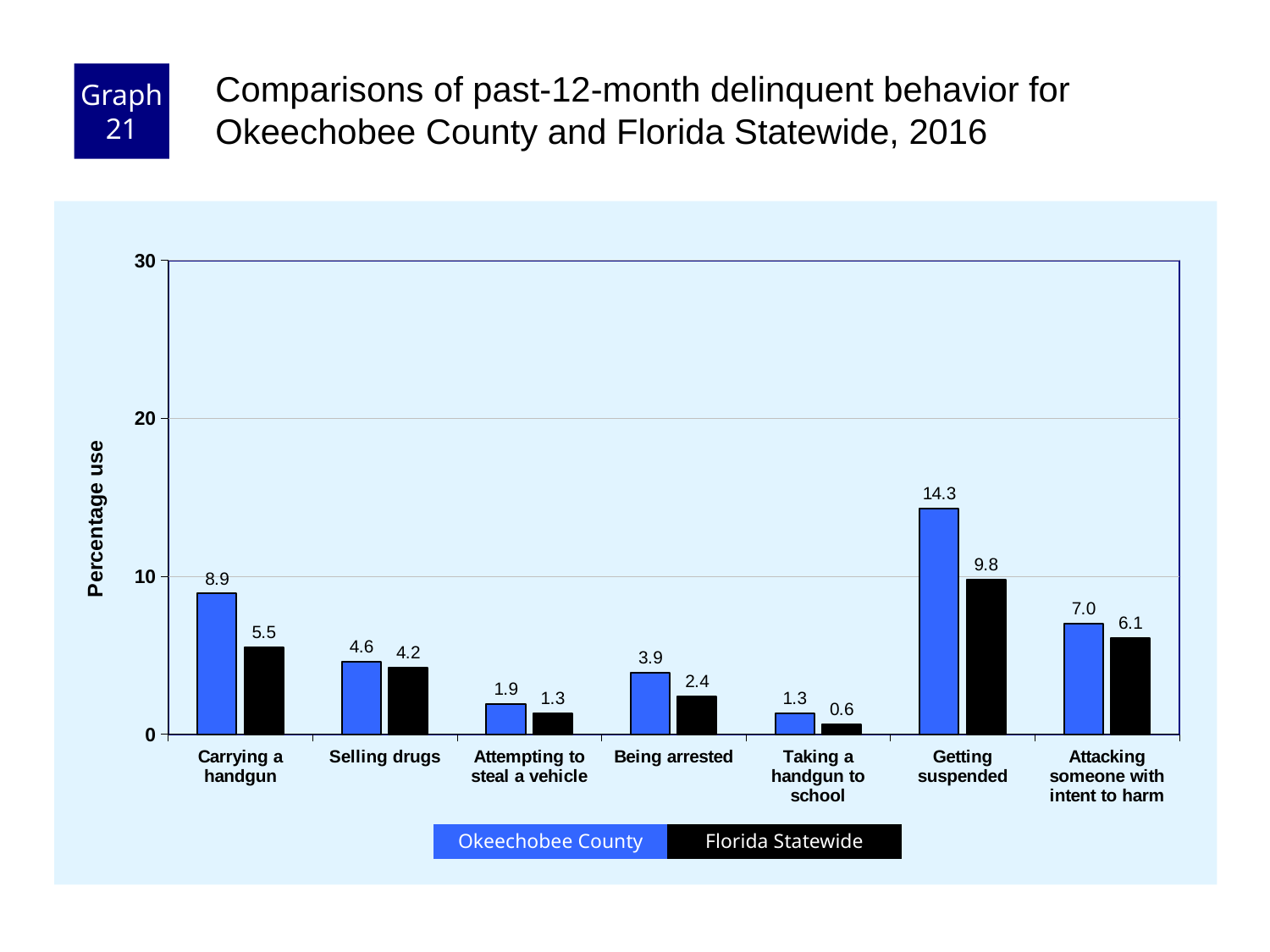
What kind of chart is shown on the slide? bar chart What is the difference between the Okeechobee County and Florida Statewide values for Carrying a handgun? 3.4 Is the Okeechobee County value for Getting suspended greater or less than 10? greater How many series does the legend list? 2 How many categories are shown on the x axis? 7 What is the Florida Statewide value for Carrying a handgun? 5.5 Which category has the lowest Florida Statewide value? Taking a handgun to school Which is larger for Being arrested: the Okeechobee County value or the Florida Statewide value? Okeechobee County What is the Okeechobee County value for Taking a handgun to school? 1.3 What is the Okeechobee County value for Getting suspended? 14.3 Which category has the highest Okeechobee County value? Getting suspended What is the difference between the Okeechobee County and Florida Statewide values for Getting suspended? 4.5